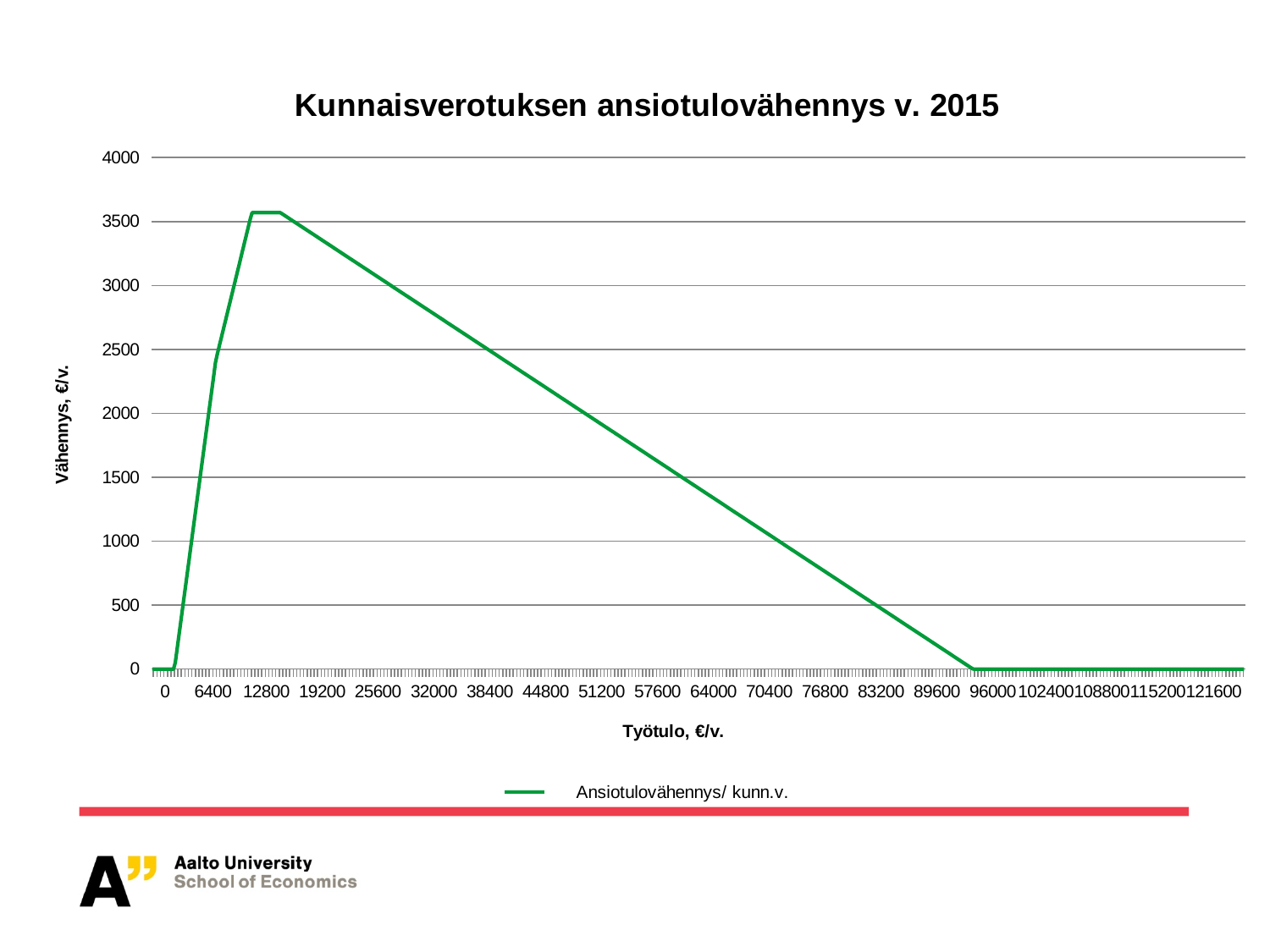
Between a Työtulo of 19200 and 89600, does the line rise or fall? fall Is the value at a Työtulo of 32000 greater or less than 2500? greater Is the peak value of the line greater or less than 3500? greater What kind of chart is shown on the slide? line chart What is the title of the chart? Kunnaisverotuksen ansiotulovähennys v. 2015 What is the value of the line at a Työtulo of 0? 0 Is the value at a Työtulo of 89600 greater or less than 500? less How many series does the legend list? 1 What is the value of the line at a Työtulo of 121600? 0 What is the legend entry for the plotted line? Ansiotulovähennys/ kunn.v. Which is larger: the value at a Työtulo of 25600 or at 70400? 25600